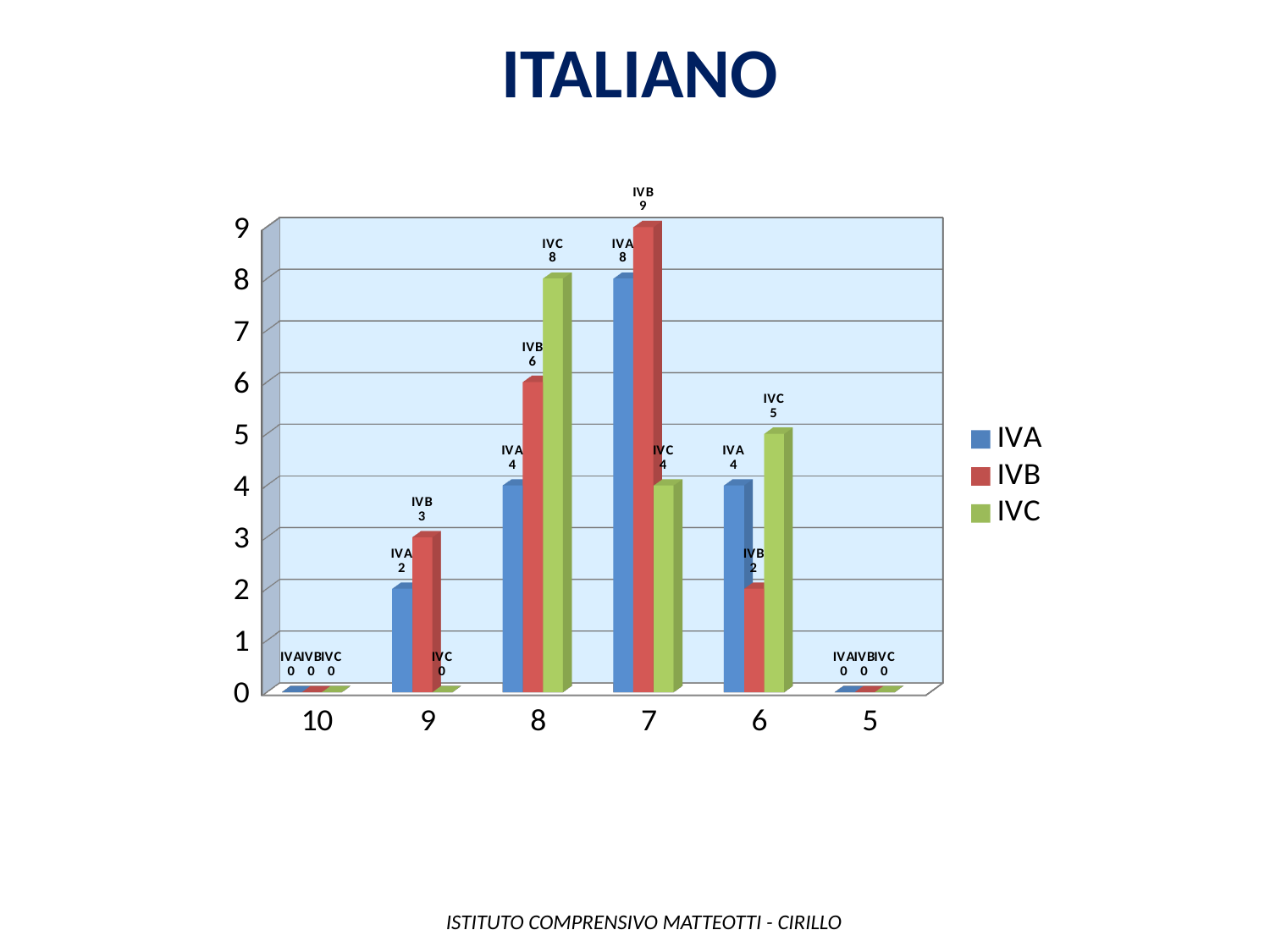
What kind of chart is shown on the slide? Bar chart For the IVB series, which grade has the highest value? 7 How many series does the legend list? 3 At grade 6, which series has the larger value, IVA or IVB? IVA How many grade categories are shown on the x axis? 6 What is the value for IVC at grade 8? 8 What is the difference between the IVC value and the IVA value at grade 8? 4 What is the value for IVA at grade 9? 2 What is the value for IVB at grade 7? 9 What is the value for IVC at grade 6? 5 For the IVC series, which grade has the highest value? 8 What is the title of the chart? ITALIANO